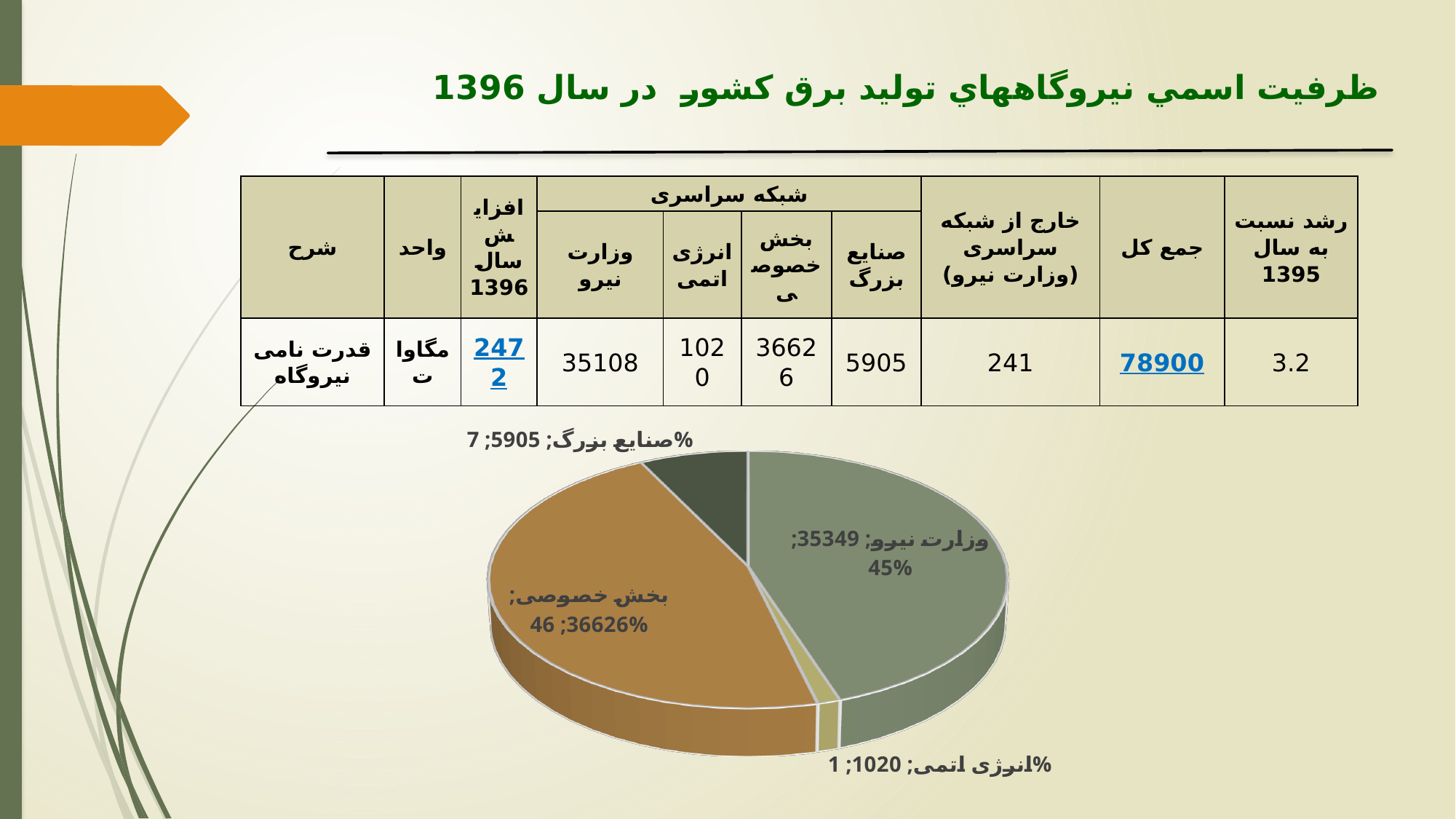
What value is shown for the صنایع بزرگ slice in the pie chart? 5905 What share of the pie does صنایع بزرگ represent? 7% What share of the pie does وزارت نیرو represent? 45% What kind of chart is shown on the slide? pie chart What value is shown for the انرژی اتمی slice in the pie chart? 1020 What is the difference between the بخش خصوصی value and the وزارت نیرو value in the pie chart? 1277 Which slice of the pie chart is the largest? بخش خصوصی What value is shown for the وزارت نیرو slice in the pie chart? 35349 Which is larger in the pie chart, صنایع بزرگ or انرژی اتمی? صنایع بزرگ What value is shown for the بخش خصوصی slice in the pie chart? 36626 Which slice of the pie chart is the smallest? انرژی اتمی How many slices does the pie chart have? 4